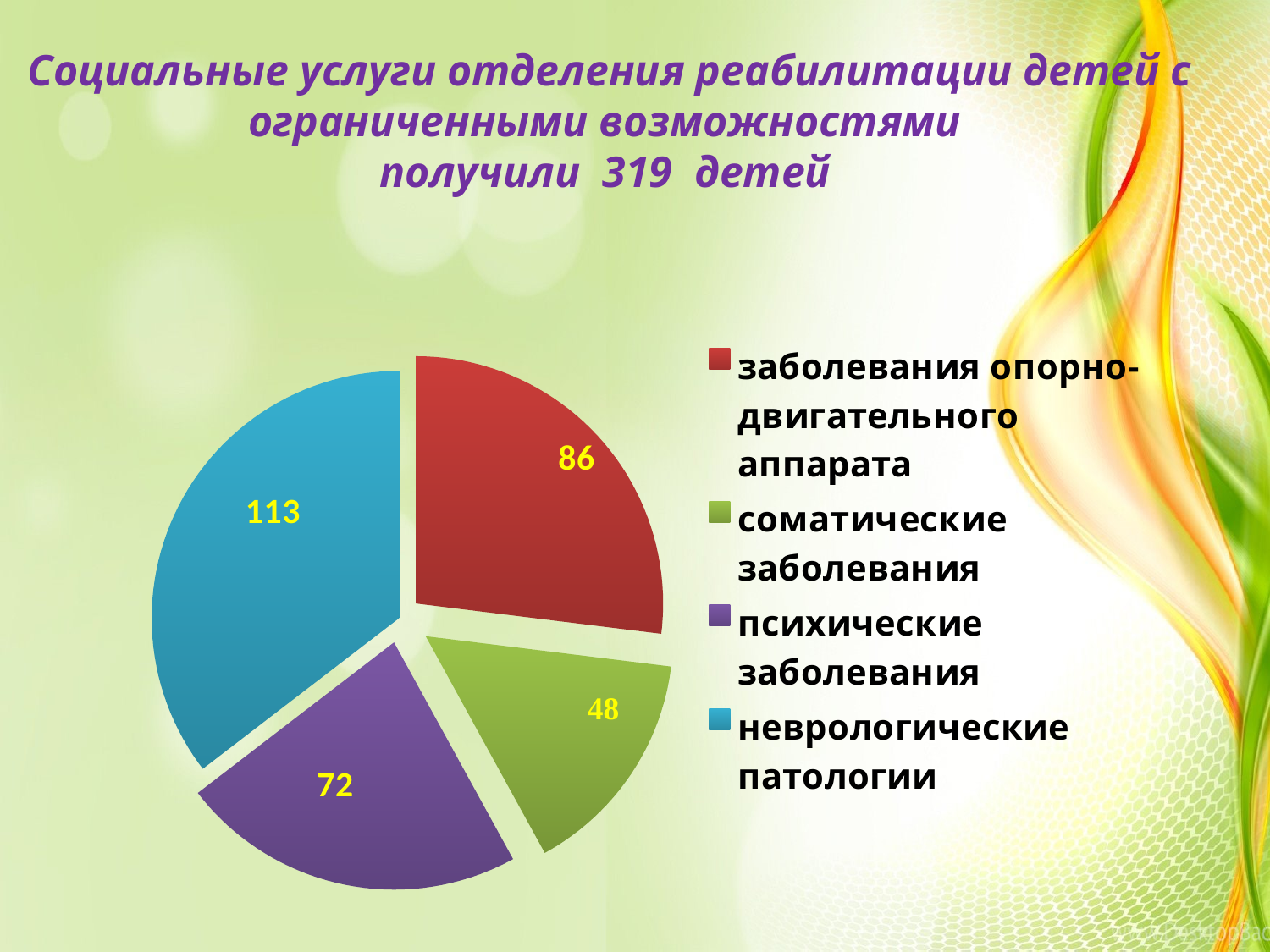
What is the total of all slices in the pie chart? 319 How many children are in the 'неврологические патологии' slice? 113 Which category has the largest slice of the pie? неврологические патологии What value is shown for 'психические заболевания'? 72 What is the difference between the values for 'неврологические патологии' and 'соматические заболевания'? 65 How many categories does the pie chart have? 4 What value is shown for 'соматические заболевания'? 48 What type of chart is shown on the slide? pie chart What value is shown for 'заболевания опорно-двигательного аппарата'? 86 Which is larger: 'заболевания опорно-двигательного аппарата' or 'психические заболевания'? заболевания опорно-двигательного аппарата What colour is the slice for 'психические заболевания'? purple Which category has the smallest slice of the pie? соматические заболевания